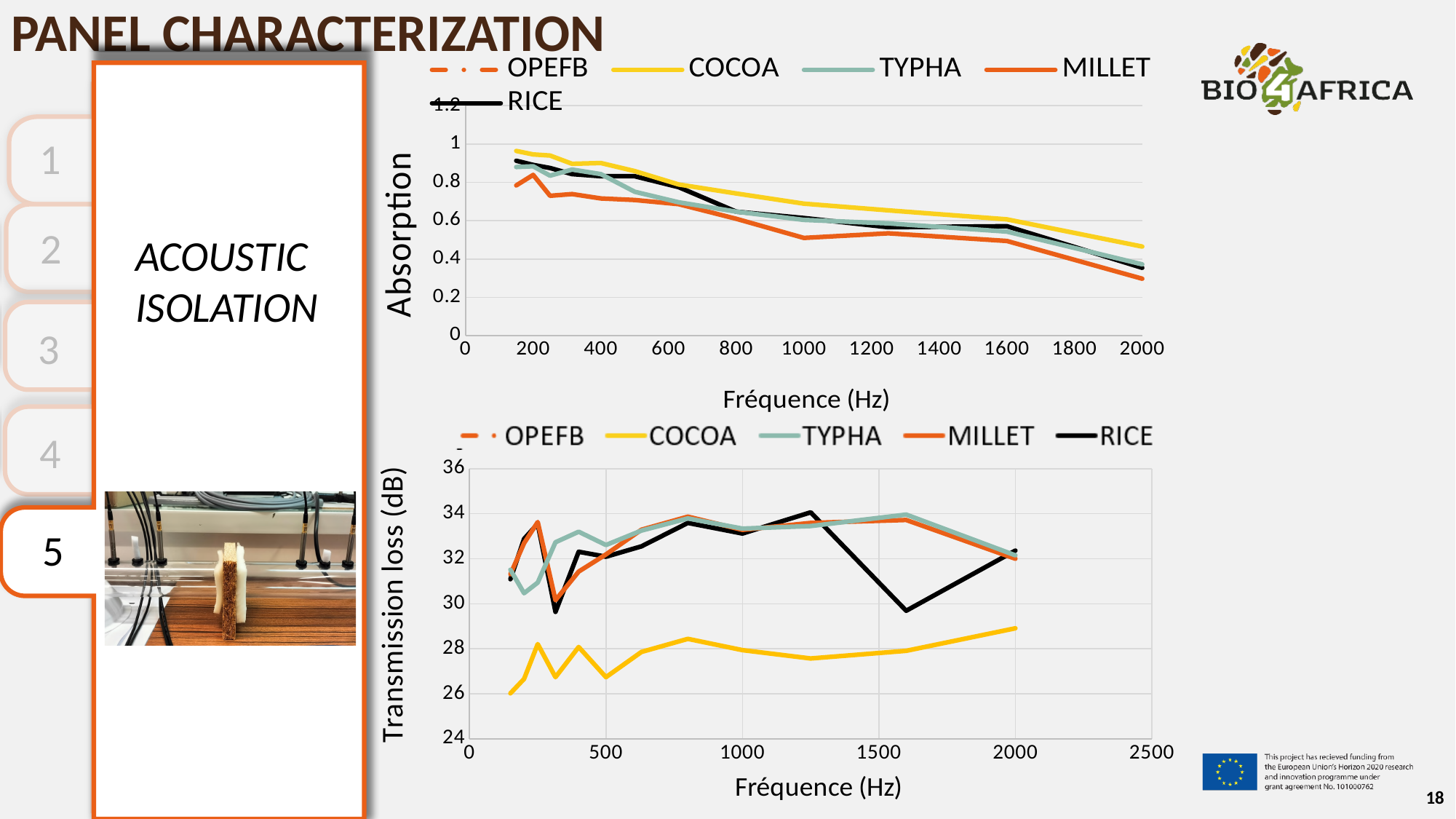
In the bottom chart (Transmission loss), is the transmission loss of COCOA at 2000 Hz greater or less than 30 dB? less In the top chart (Absorption), is the absorption of COCOA at 200 Hz greater or less than 0.8? greater In the top chart (Absorption), which series has the lowest absorption at 2000 Hz? MILLET What kind of chart is the top chart (Absorption vs Fréquence)? Line chart How many series does the legend of the bottom chart (Transmission loss) list? 5 What is the x-axis title of the bottom chart (Transmission loss)? Fréquence (Hz) In the bottom chart (Transmission loss), which has the larger transmission loss at 1600 Hz, MILLET or RICE? MILLET In the top chart (Absorption), which series has the highest absorption at 2000 Hz? COCOA In the top chart (Absorption), is the absorption of MILLET at 2000 Hz greater or less than 0.4? less In the top chart (Absorption), do the absorption values generally rise or fall as frequency increases? Fall In the bottom chart (Transmission loss), which series has the lowest transmission loss across the frequency range? COCOA